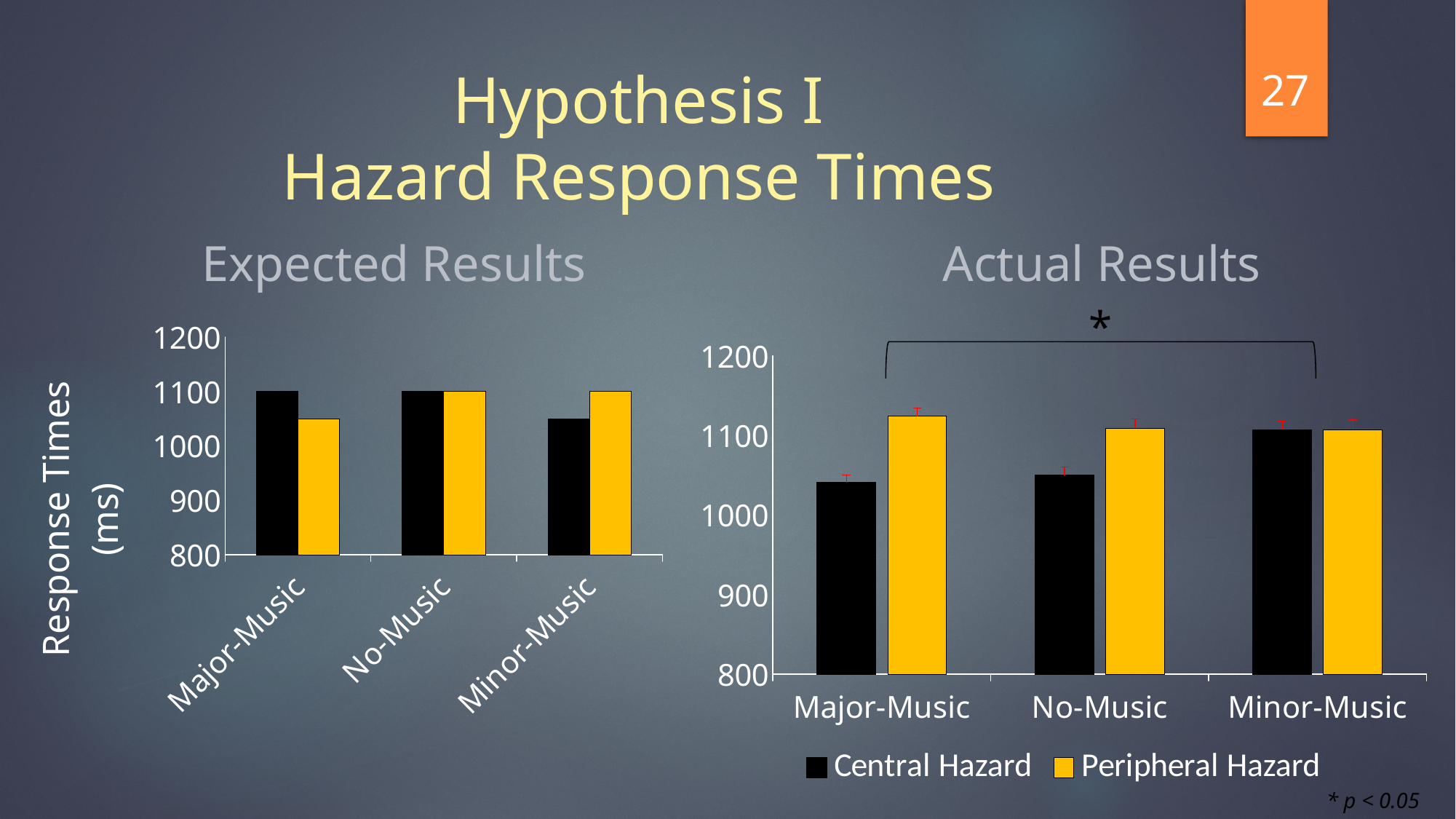
In the Actual Results chart, is the Peripheral Hazard value for Major-Music greater or less than 1100? greater In the Expected Results chart, which bar is taller for Minor-Music, the black bar or the yellow bar? the yellow bar What kind of chart is the Expected Results chart? bar chart How many series does the legend of the Actual Results chart list? 2 How many categories are shown on the x axis of the Expected Results chart? 3 In the Actual Results chart, is the Central Hazard value for No-Music greater or less than 1100? less In the Actual Results chart, which category has the highest Peripheral Hazard value? Major-Music In the Actual Results chart, which series has the larger value for Major-Music, Central Hazard or Peripheral Hazard? Peripheral Hazard In the Actual Results chart, is the Central Hazard value for Major-Music greater or less than 1100? less In the Actual Results chart, which category has the highest Central Hazard value? Minor-Music In the Expected Results chart, what is the value of the black bar for No-Music? 1100 What is the y-axis label of the Expected Results chart? Response Times (ms)